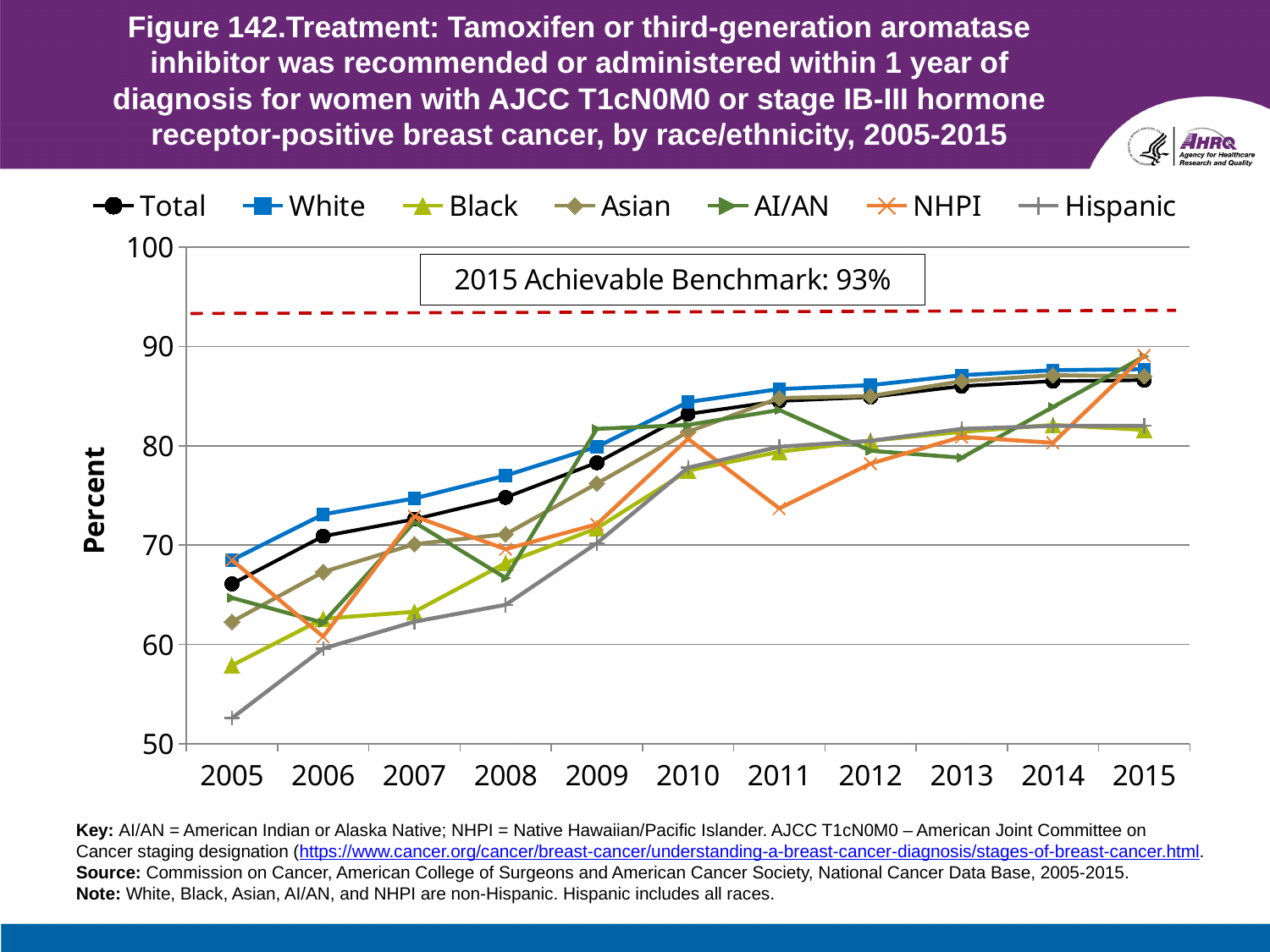
What is the 2015 achievable benchmark shown on the chart? 93% Which group has the lowest value in 2005? Hispanic Does the Total series rise or fall from 2005 to 2015? rise How many series does the legend list? 7 Is the value for White in 2010 greater or less than 80? greater Is the value for Hispanic in 2005 greater or less than 60? less What kind of chart is shown on the slide? line chart In 2005, which is larger, the value for White or the value for Hispanic? White How many years are plotted along the x axis? 11 Is the value for White in 2015 greater or less than 90? less What is the label on the y axis? Percent